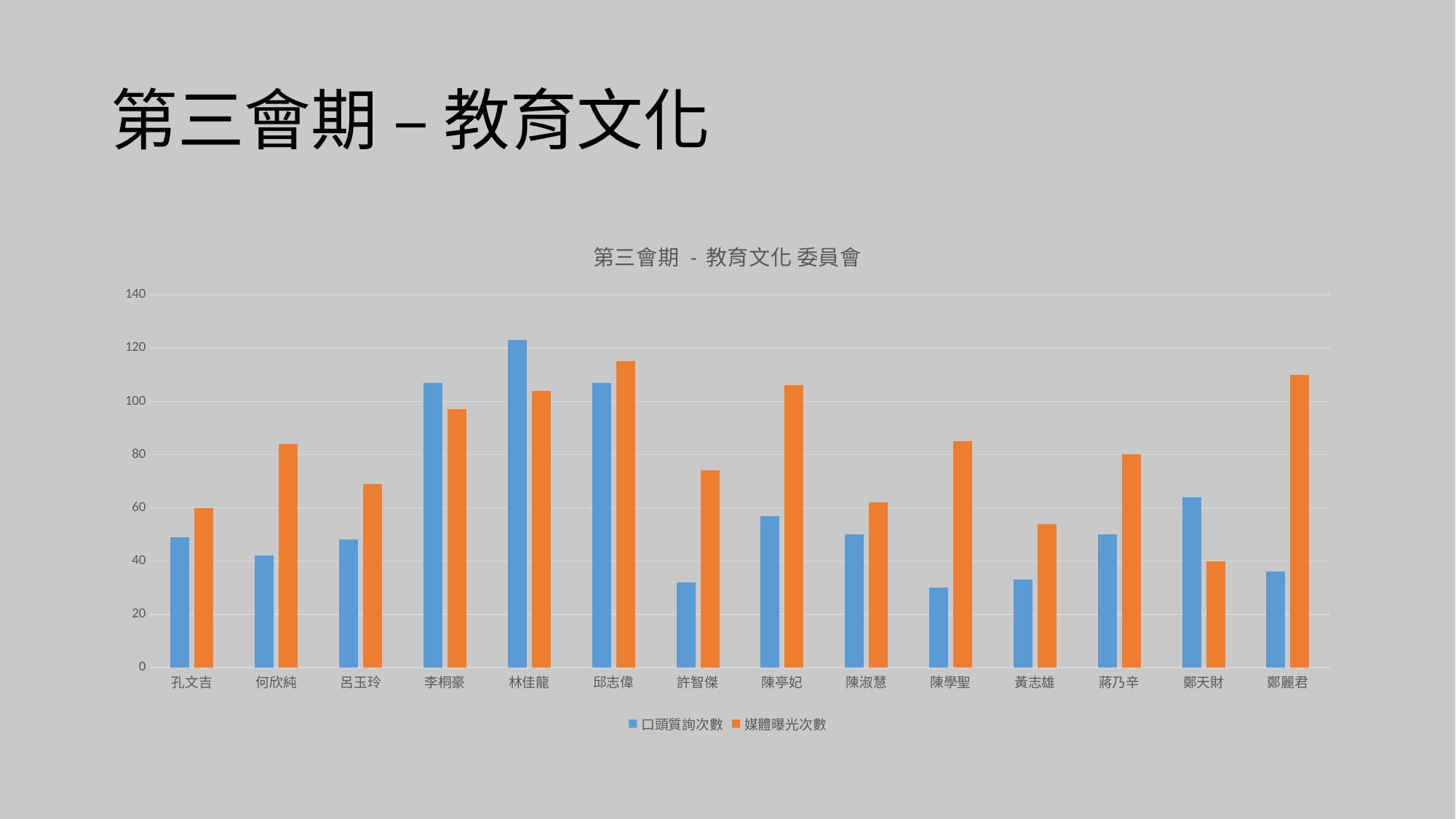
Is the 口頭質詢次數 value for 何欣純 greater or less than 60? less For 鄭天財, which is larger: 口頭質詢次數 or 媒體曝光次數? 口頭質詢次數 Is the 媒體曝光次數 value for 鄭天財 greater or less than 60? less What is the title of the chart? 第三會期 - 教育文化 委員會 How many categories (legislators) are shown on the x axis? 14 Which category has the lowest value for 媒體曝光次數? 鄭天財 What kind of chart is shown on the slide? bar chart How many series does the legend list? 2 For 陳亭妃, which is larger: 口頭質詢次數 or 媒體曝光次數? 媒體曝光次數 Which category has the highest value for 口頭質詢次數? 林佳龍 Is the 口頭質詢次數 value for 林佳龍 greater or less than 100? greater